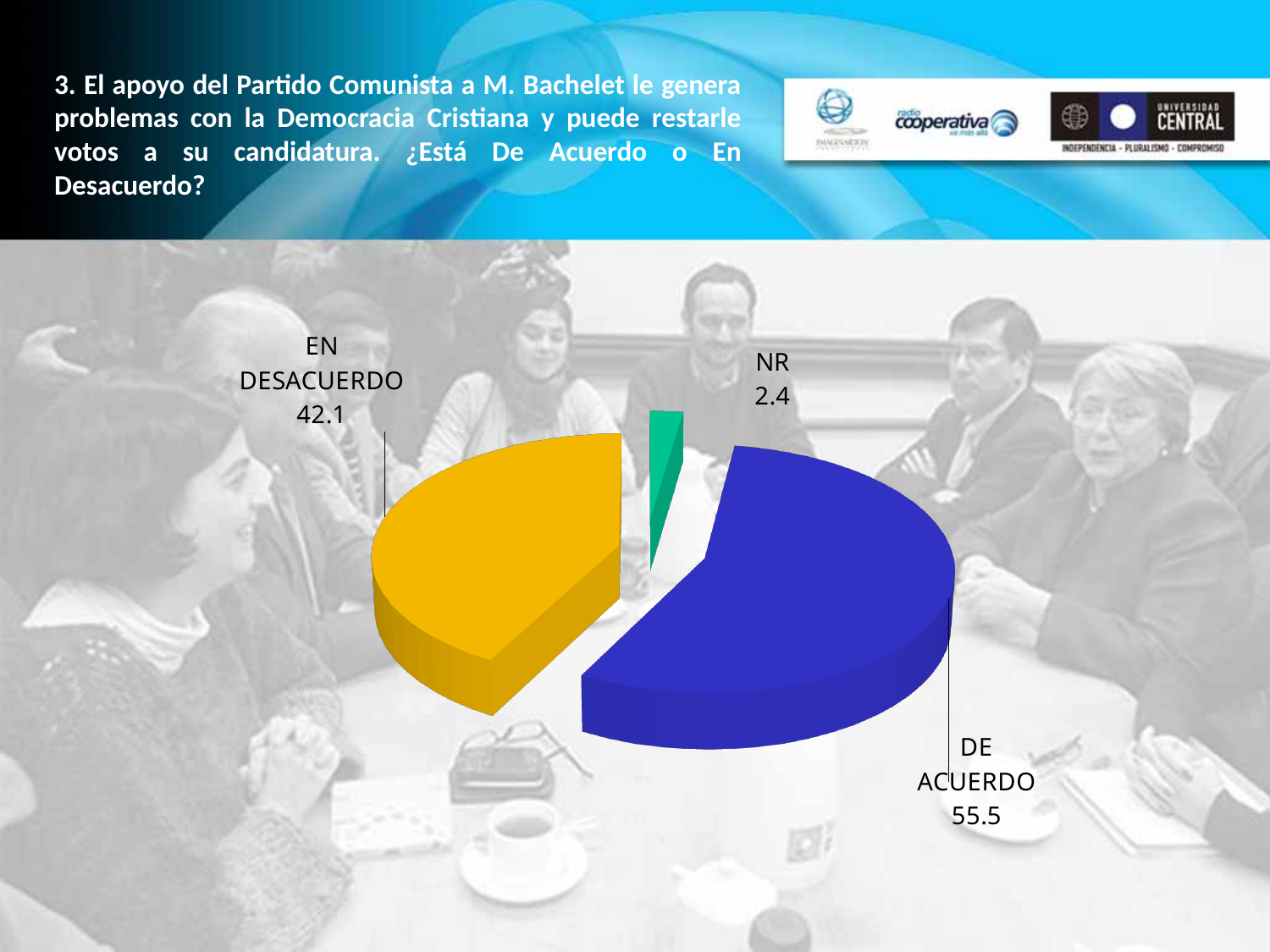
What is the difference between the EN DESACUERDO and NR values? 39.7 What colour is the EN DESACUERDO slice? Yellow Which is larger, DE ACUERDO or EN DESACUERDO? DE ACUERDO Which slice of the pie has the smallest value? NR How many slices does the pie chart have? 3 What value is shown for EN DESACUERDO? 42.1 What value is shown for DE ACUERDO? 55.5 Which slice of the pie has the largest value? DE ACUERDO What is the difference between the DE ACUERDO and EN DESACUERDO values? 13.4 What kind of chart is shown on the slide? Pie chart What value is shown for NR? 2.4 What colour is the DE ACUERDO slice? Blue